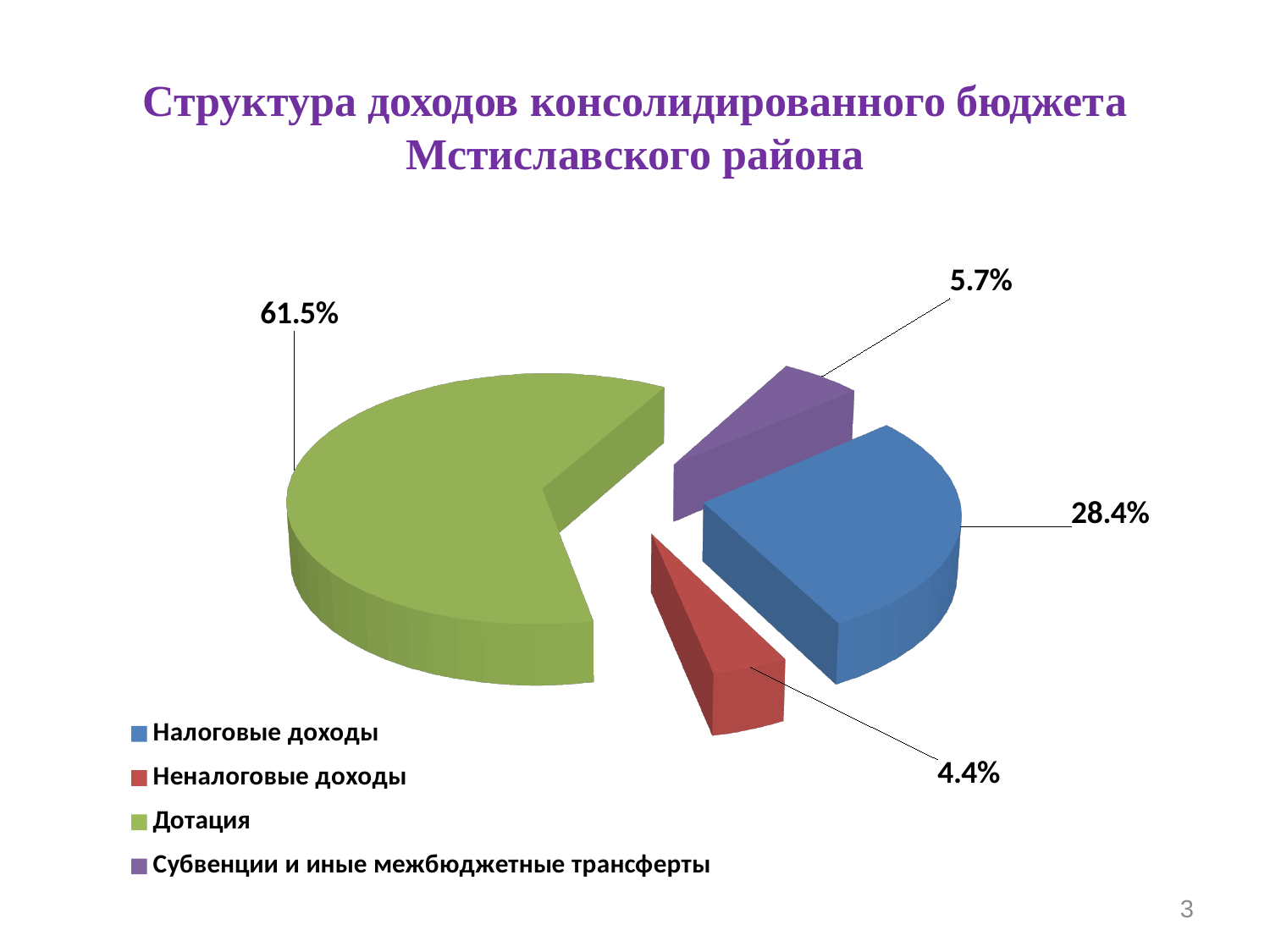
What is the value shown for Налоговые доходы? 28.4% Which is larger, Налоговые доходы or Неналоговые доходы? Налоговые доходы What is the value shown for Неналоговые доходы? 4.4% How many categories does the pie chart show? 4 What is the value shown for Субвенции и иные межбюджетные трансферты? 5.7% What is the difference in percentage points between Дотация and Налоговые доходы? 33.1 What share of the pie does Дотация have? 61.5% What is the title of the chart? Структура доходов консолидированного бюджета Мстиславского района What colour is the slice for Субвенции и иные межбюджетные трансферты? Purple Which category has the smallest slice of the pie? Неналоговые доходы Which category has the largest slice of the pie? Дотация What kind of chart is shown on the slide? Pie chart